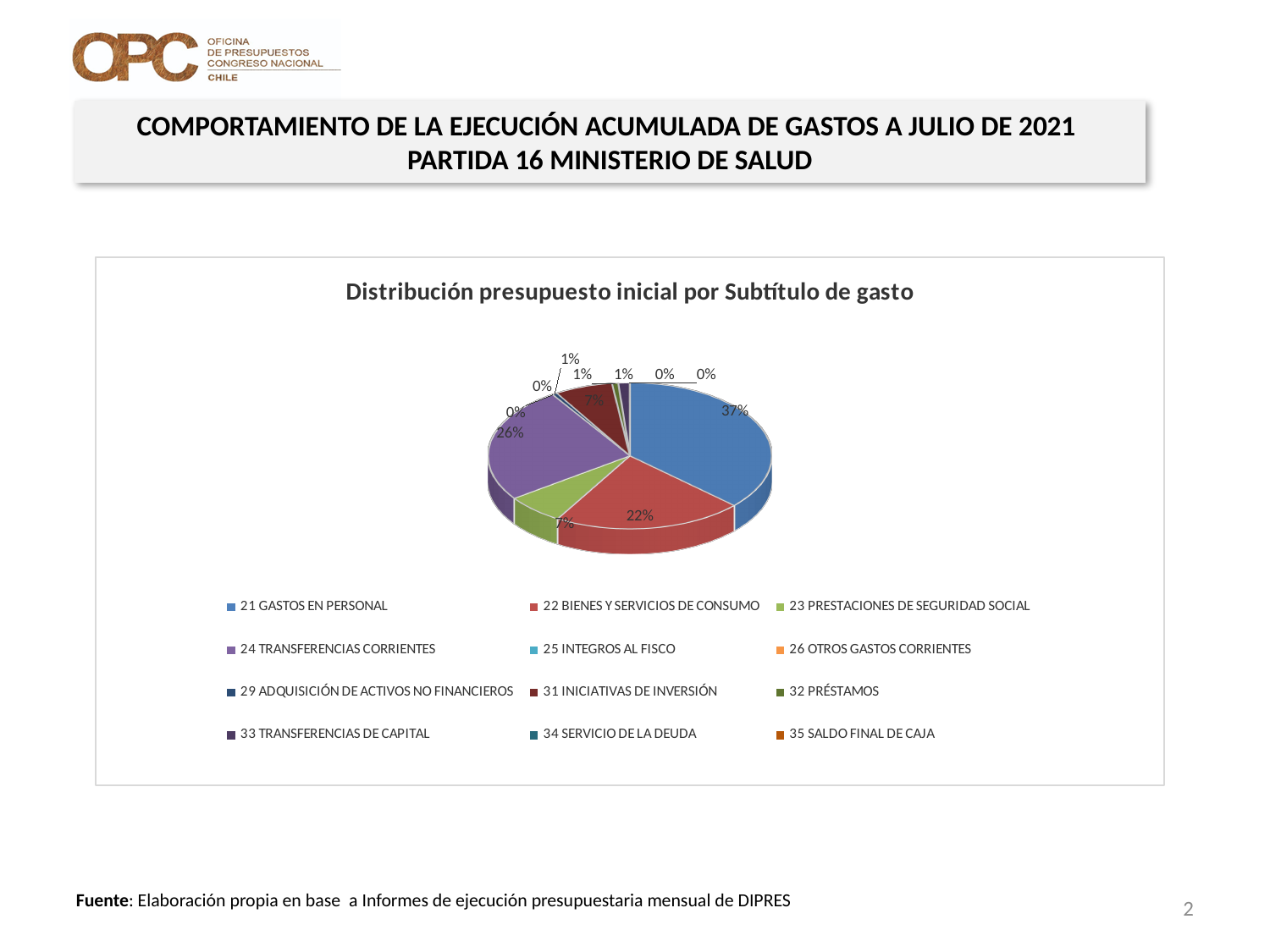
How many entries does the chart legend list? 12 What share of the pie does 31 INICIATIVAS DE INVERSIÓN represent? 7% By how many percentage points does the share of 21 GASTOS EN PERSONAL exceed that of 24 TRANSFERENCIAS CORRIENTES? 11 percentage points What is the title of the chart? Distribución presupuesto inicial por Subtítulo de gasto Which category has the largest slice of the pie? 21 GASTOS EN PERSONAL What share of the pie does 22 BIENES Y SERVICIOS DE CONSUMO represent? 22% By how many percentage points does the share of 21 GASTOS EN PERSONAL exceed that of 22 BIENES Y SERVICIOS DE CONSUMO? 15 percentage points Which is larger, the slice for 22 BIENES Y SERVICIOS DE CONSUMO or the slice for 24 TRANSFERENCIAS CORRIENTES? 24 TRANSFERENCIAS CORRIENTES What share of the pie does 21 GASTOS EN PERSONAL represent? 37% What kind of chart is shown on the slide? Pie chart